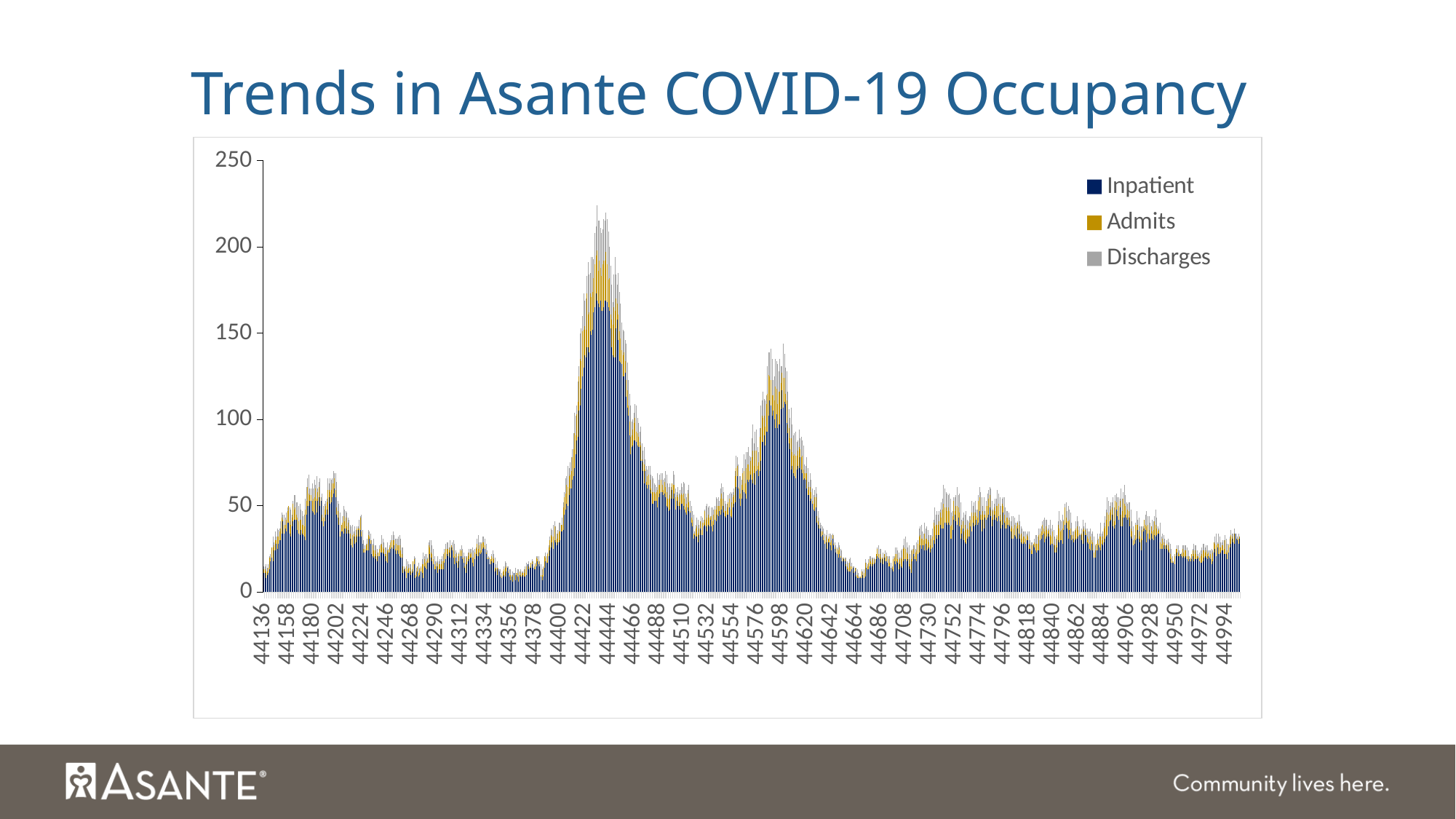
What is the title of the chart? Trends in Asante COVID-19 Occupancy Is the stacked bar total at the x-axis label 44598 greater or less than 100? greater Which series is shown in gold/yellow in the legend? Admits How many series does the legend list? 3 Is the stacked bar total at the x-axis label 44356 greater or less than 50? less Is the highest stacked bar total on the chart greater or less than 200? greater Do the stacked bar totals rise or fall between the x-axis labels 44598 and 44664? fall What kind of chart is shown on the slide? Bar chart Do the stacked bar totals rise or fall between the x-axis labels 44400 and 44444? rise